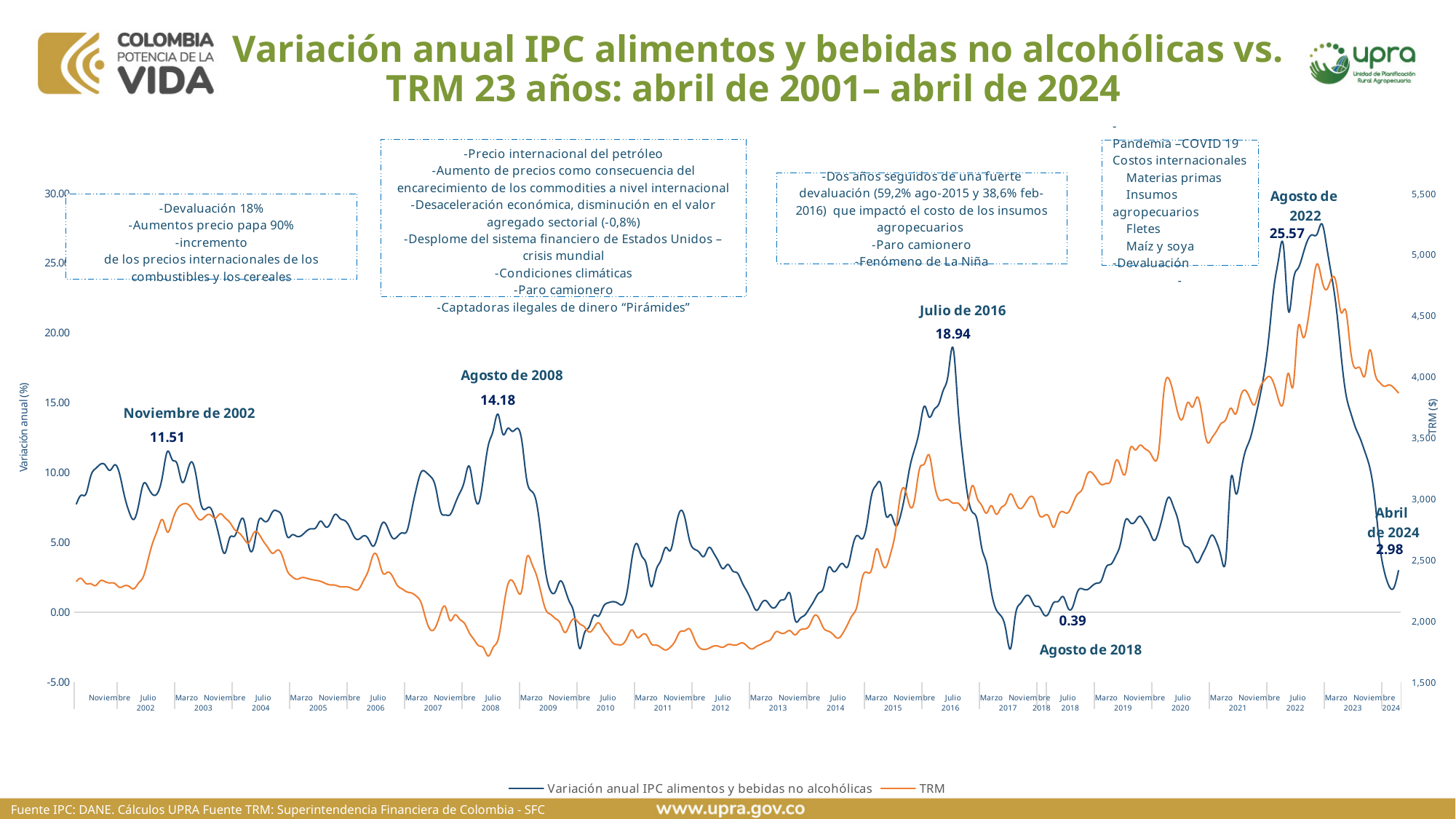
What is the labelled value of the annual IPC variation for Julio de 2016? 18.94 Which labelled point has the lowest annual IPC variation? Agosto de 2018 Which is larger, the labelled IPC value for Agosto de 2008 or for Julio de 2016? Julio de 2016 How many series does the legend list? 2 What is the labelled value of the annual IPC variation for Agosto de 2018? 0.39 What type of chart is shown on the slide? line chart What is the labelled value of the annual IPC variation for Abril de 2024? 2.98 Which labelled point has the highest annual IPC variation? Agosto de 2022 What is the labelled value of the annual IPC variation for Noviembre de 2002? 11.51 What is the difference between the labelled IPC values for Agosto de 2022 and Julio de 2016? 6.63 Is the TRM value at the end of the series (2024) greater or less than 3,500? greater What is the labelled value of the annual food and non-alcoholic beverages IPC variation for Agosto de 2022? 25.57